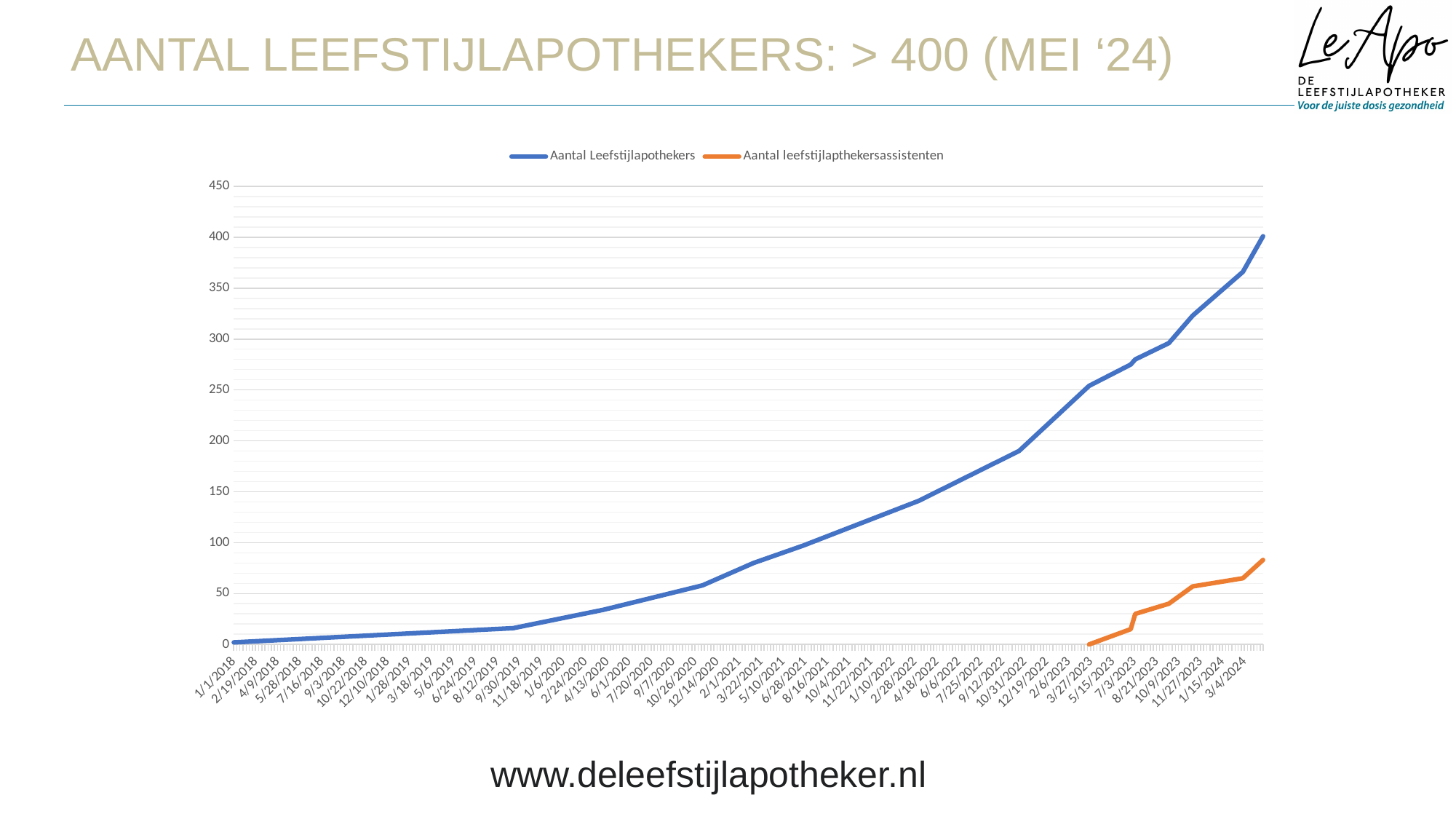
What is the title of the slide containing the chart? AANTAL LEEFSTIJLAPOTHEKERS: > 400 (MEI '24) Is the value of Aantal leefstijlapthekersassistenten at 8/21/2023 greater or less than 50? less Is the value of Aantal Leefstijlapothekers at 2/1/2021 greater or less than 100? less At the last date on the x axis, which series has the larger value: Aantal Leefstijlapothekers or Aantal leefstijlapthekersassistenten? Aantal Leefstijlapothekers What kind of chart is shown on the slide? line chart What are the two series named in the legend? Aantal Leefstijlapothekers; Aantal leefstijlapthekersassistenten Does the Aantal Leefstijlapothekers series rise or fall over time along the x axis? rise How many series does the legend list? 2 Does the Aantal leefstijlapthekersassistenten series rise or fall over time along the x axis? rise Is the final value of Aantal leefstijlapthekersassistenten at 3/4/2024 greater or less than 100? less